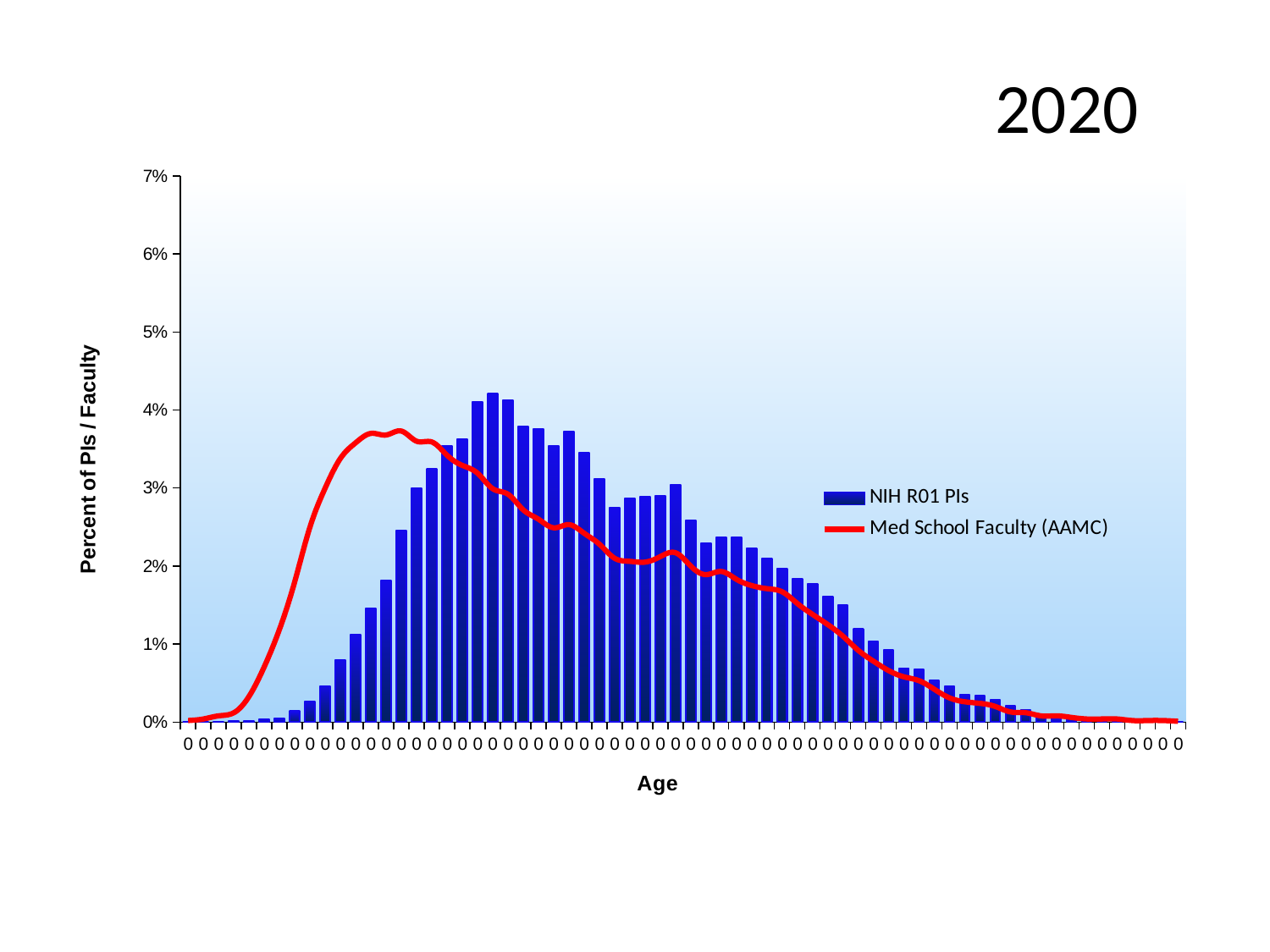
Is the tallest NIH R01 PIs bar greater or less than 5%? less What is the title of the vertical axis? Percent of PIs / Faculty What are the two series named in the legend? NIH R01 PIs; Med School Faculty (AAMC) What kind of chart is shown on the slide? Bar chart with a line series Is the tallest NIH R01 PIs bar greater or less than 4%? greater Is the peak of the Med School Faculty (AAMC) line greater or less than 4%? less How many series does the legend list? 2 Does the Med School Faculty (AAMC) line peak to the left or to the right of the tallest NIH R01 PIs bar? left Which series reaches a higher peak value, NIH R01 PIs or Med School Faculty (AAMC)? NIH R01 PIs